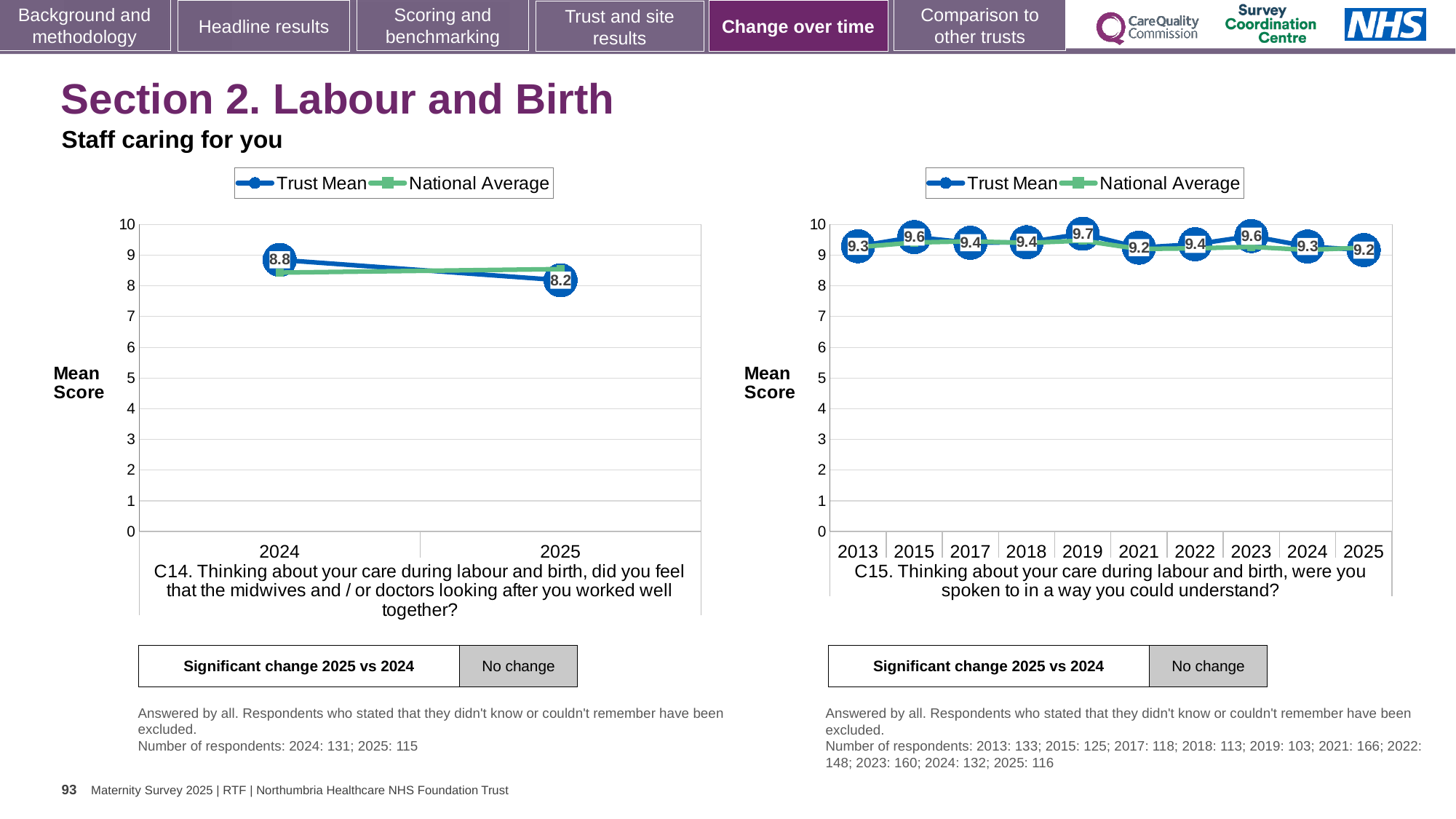
On the C14 chart (left), is the National Average for 2024 greater or less than 8? greater What kind of chart is the C14 chart (left)? line chart On the C15 chart (right), in which year is the Trust Mean highest? 2019 On the C14 chart (left), what is the difference between the Trust Mean for 2024 and 2025? 0.6 On the C14 chart (left), does the Trust Mean rise or fall from 2024 to 2025? fall On the C15 chart (right), what is the lowest Trust Mean value shown? 9.2 On the C14 chart (left), what is the Trust Mean for 2024? 8.8 On the C15 chart (right), which is larger, the Trust Mean for 2019 or for 2021? 2019 On the C14 chart (left), what is the Trust Mean for 2025? 8.2 On the C15 chart (right), what is the Trust Mean for 2019? 9.7 On the C15 chart (right), how many years are plotted on the x axis? 10 How many series does the legend of the C15 chart (right) list? 2